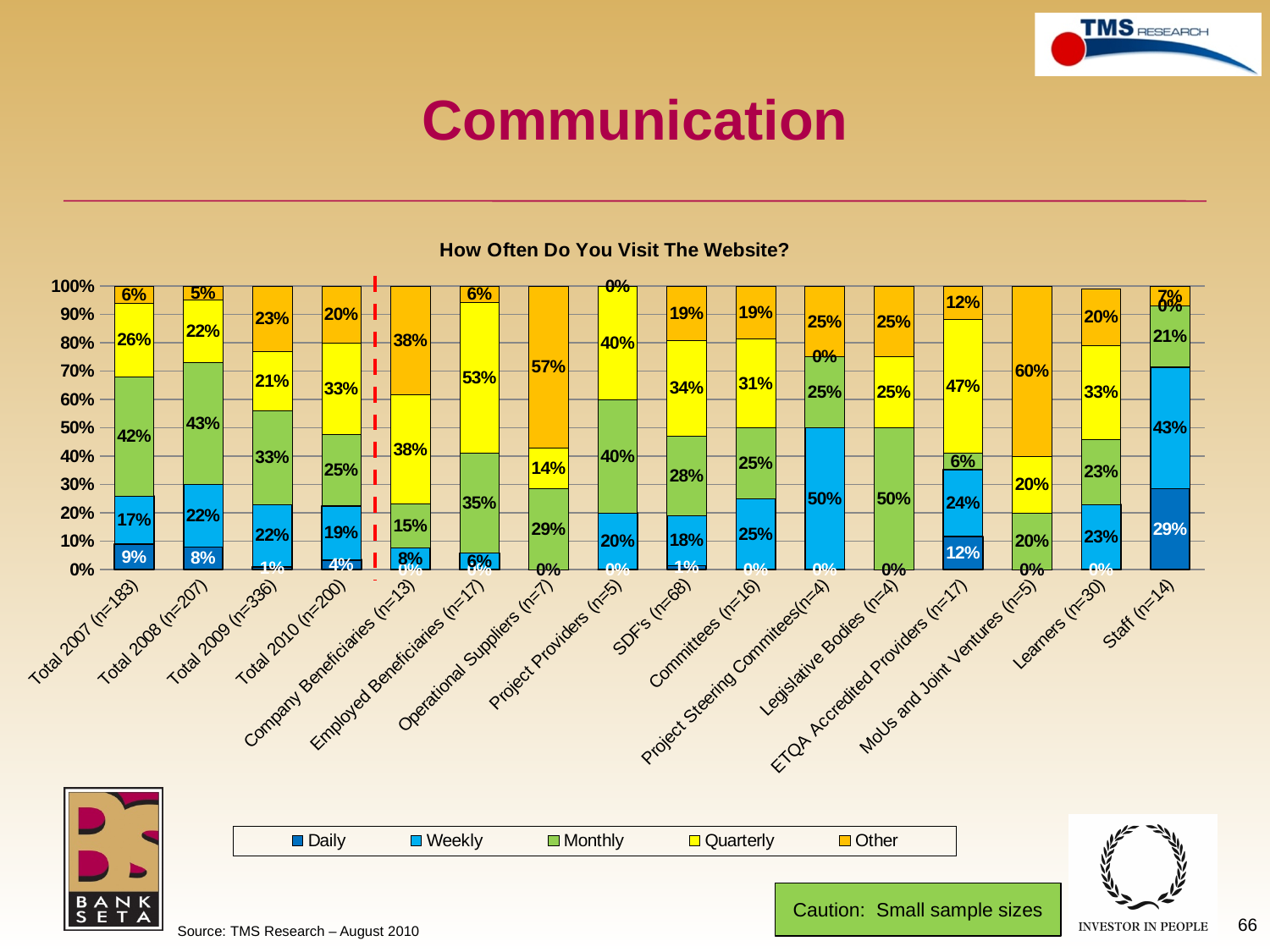
What is the Monthly value for Total 2008 (n=207)? 43% What kind of chart is shown on the slide? stacked bar chart What is the difference between the Quarterly value for Total 2010 (n=200) and the Quarterly value for Total 2007 (n=183)? 7% What is the Weekly value for Project Steering Committees (n=4)? 50% How many series does the legend list? 5 What is the Other value for Operational Suppliers (n=7)? 57% What is the Quarterly value for Employed Beneficiaries (n=17)? 53% What is the title of the chart? How Often Do You Visit The Website? Which category has the highest Other value? MoUs and Joint Ventures (n=5) Which colour represents the Quarterly series in the legend? yellow What is the Daily value for Staff (n=14)? 29% Which is larger, the Monthly value for Total 2007 (n=183) or the Monthly value for Total 2010 (n=200)? Total 2007 (n=183)